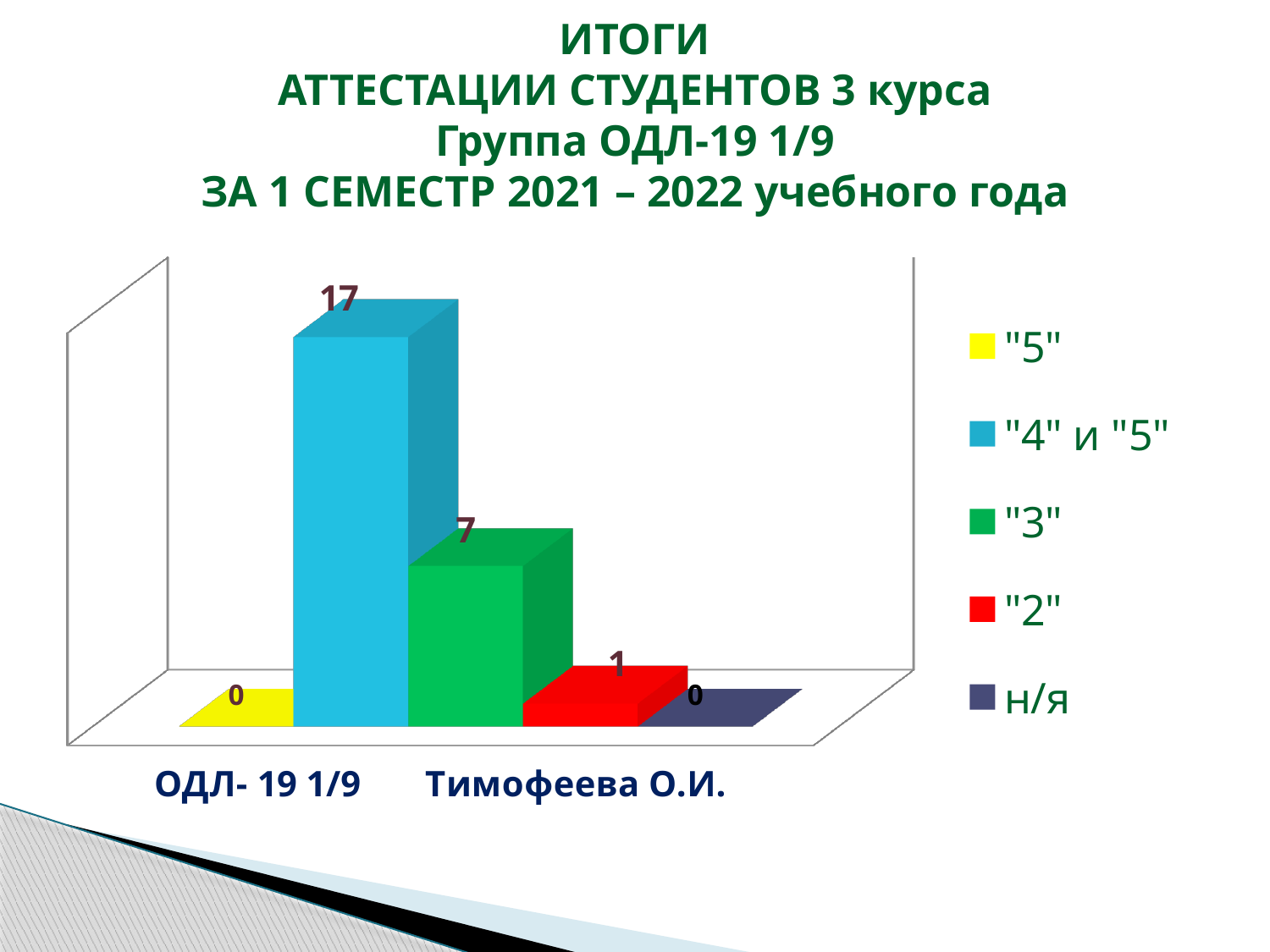
Which is larger, the value for "3" or the value for "2"? "3" What is the value for н/я? 0 What is the value for "5"? 0 What kind of chart is shown on the slide? bar chart What colour is the bar for "3"? green What is the value for "4" и "5"? 17 What is the value for "3"? 7 What is the difference between the values for "4" и "5" and "3"? 10 How many series does the legend list? 5 What is the value for "2"? 1 What is the total of all the values shown on the chart? 25 Which series has the highest value? "4" и "5"